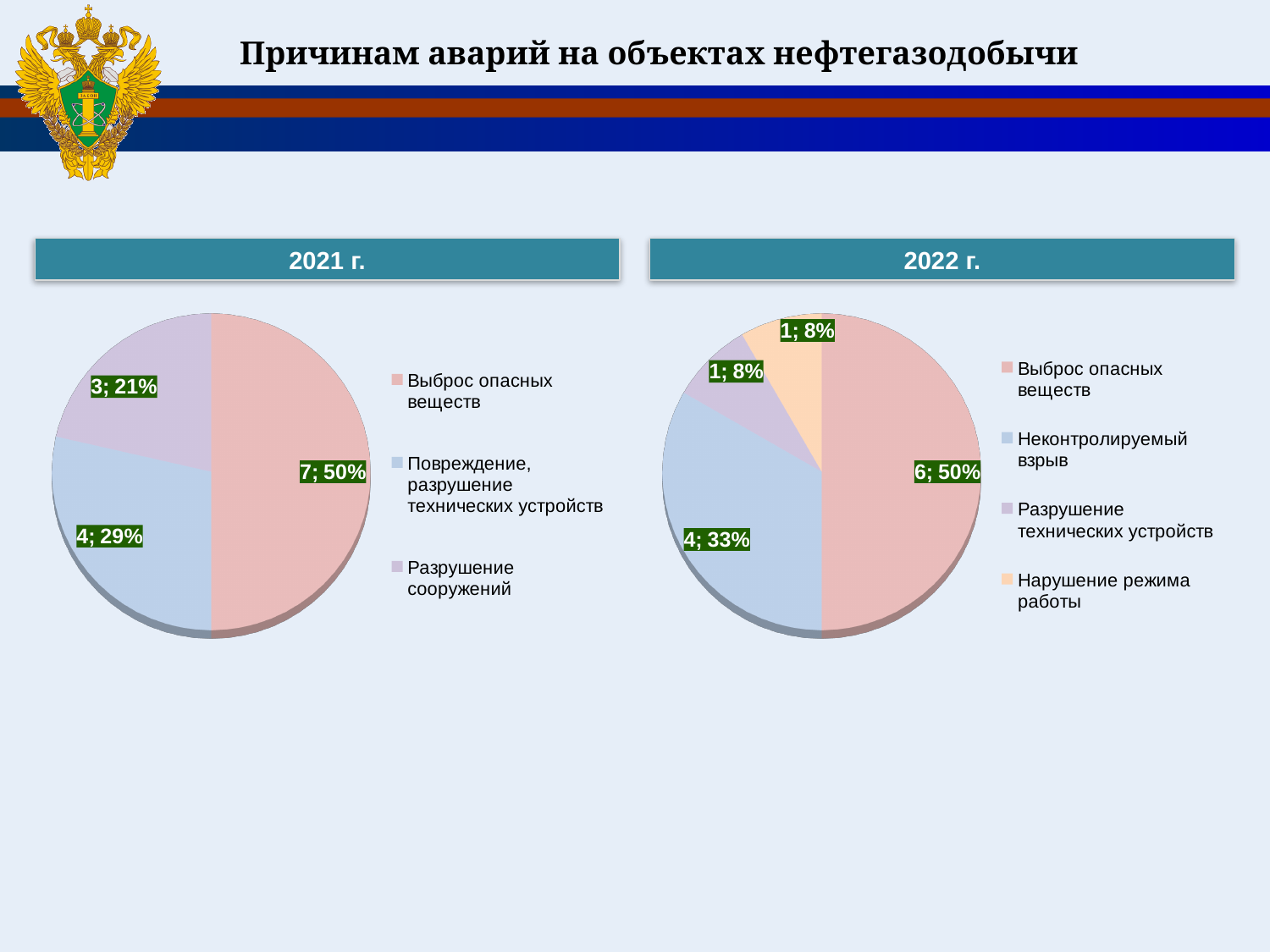
In the 2022 г. chart, what share of the pie is Нарушение режима работы? 8% In the 2022 г. chart, what share of the pie is Выброс опасных веществ? 50% In the 2021 г. chart, what is the difference between the values for Выброс опасных веществ and Разрушение сооружений? 4 In the 2021 г. chart, which category has the smallest slice? Разрушение сооружений What type of chart is used for the 2021 г. data? Pie chart In the 2022 г. chart, which is larger: Выброс опасных веществ or Неконтролируемый взрыв? Выброс опасных веществ In the 2021 г. chart, what is the value for Разрушение сооружений? 3 In the 2021 г. chart, which category has the largest slice? Выброс опасных веществ In the 2021 г. chart, how many accidents are attributed to Выброс опасных веществ? 7 In the 2022 г. chart, what is the value for Неконтролируемый взрыв? 4 How many categories does the legend of the 2022 г. chart list? 4 In the 2021 г. chart, what share of the pie is Повреждение, разрушение технических устройств? 29%